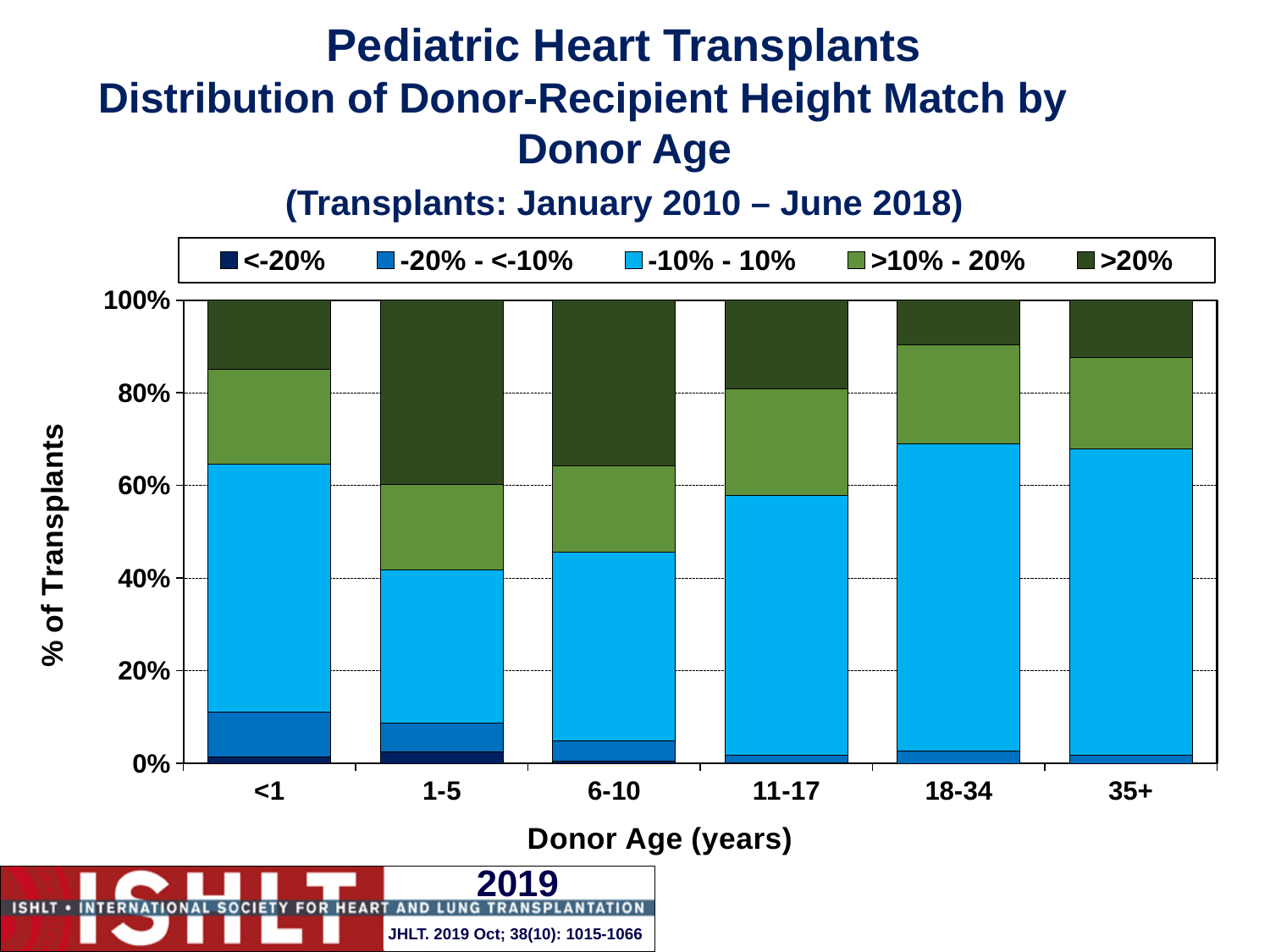
What is the total height of each stacked bar in the chart? 100% Is the top of the -10% - 10% segment for donor age 6-10 greater or less than 60%? less Is the top of the -10% - 10% segment for donor age <1 greater or less than 60%? greater Which donor age group has the smallest -10% - 10% height-match segment? 1-5 How many series does the legend list? 5 Which donor age group has the largest >20% height-match segment? 1-5 Is the >20% segment larger for donor age 1-5 or for donor age 18-34? 1-5 What kind of chart is shown on the slide? Stacked bar chart How many donor age categories are shown on the x axis? 6 What is the label of the x axis? Donor Age (years) Which donor age group has the largest -20% - <-10% height-match segment? <1 Is the top of the >10% - 20% segment for donor age 18-34 greater or less than 80%? greater